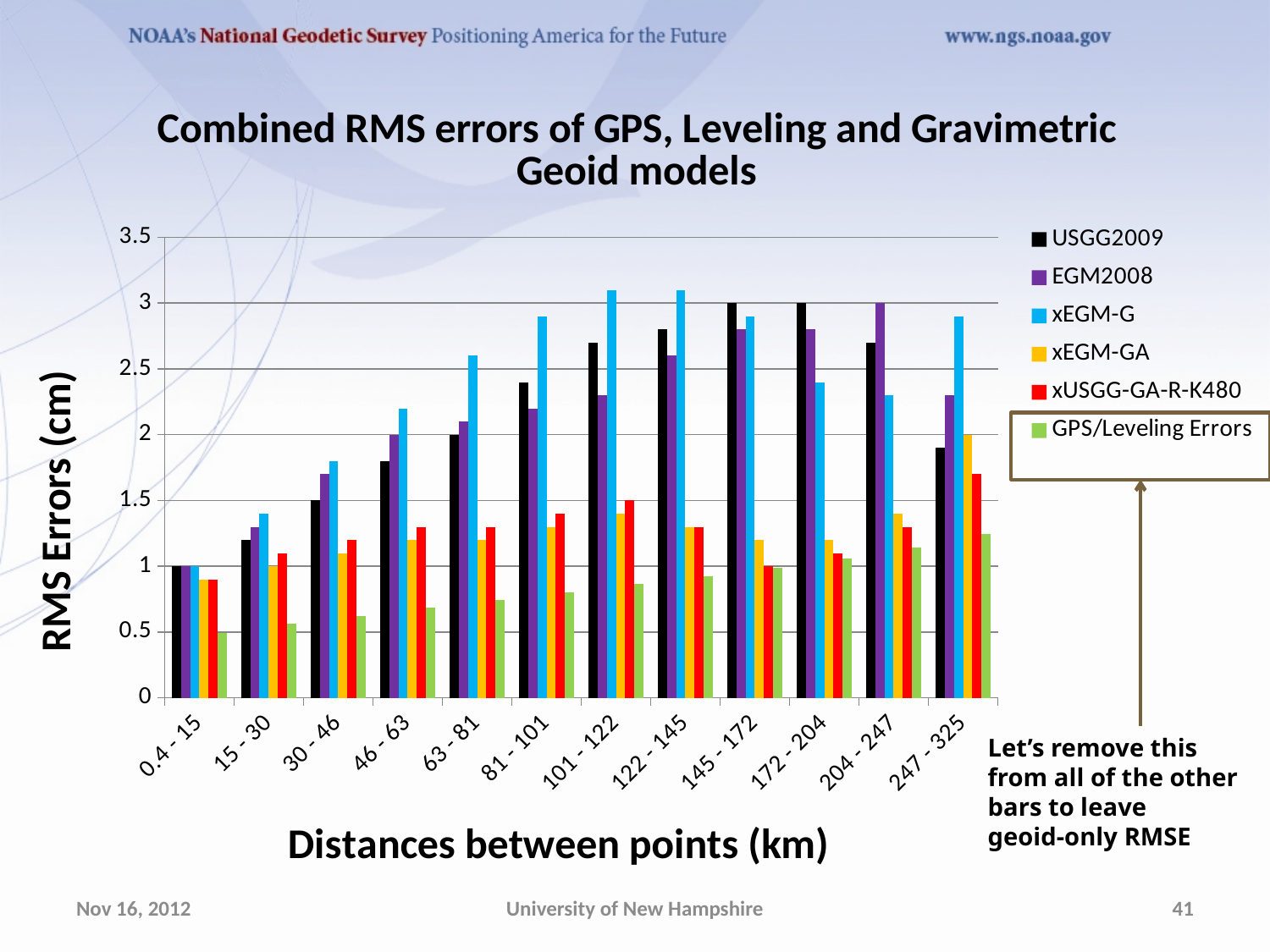
How many series does the legend list? 6 Is the value for xUSGG-GA-R-K480 at 247 - 325 km greater or less than 1.5? greater Is the value for xEGM-G at 81 - 101 km greater or less than 2.5? greater What kind of chart is shown on the slide? bar chart Which series has the lowest value in the 0.4 - 15 km category? GPS/Leveling Errors At 204 - 247 km, which is larger: USGG2009 or EGM2008? EGM2008 Do the GPS/Leveling Errors values rise or fall as the distance between points increases? rise Which series has the highest value in the 247 - 325 km category? xEGM-G Is the value for xEGM-G at 101 - 122 km greater or less than 3? greater How many distance categories are shown on the x axis? 12